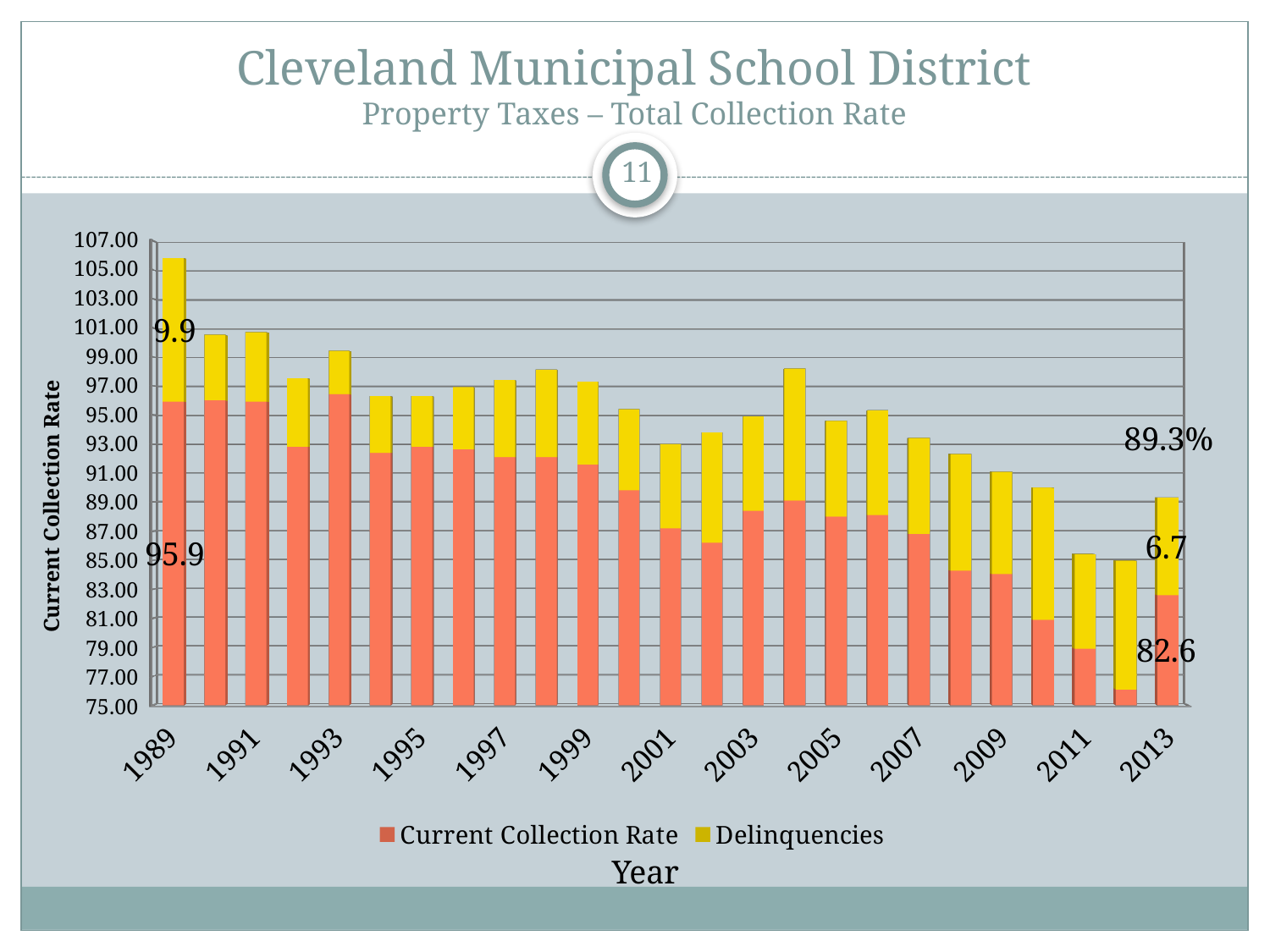
What is the Delinquencies value for 1989? 9.9 Which year has the taller stacked bar, 1989 or 2013? 1989 What is the Delinquencies value for 2013? 6.7 Is the Current Collection Rate for 2009 greater or less than 85.00? less What is the total of the stacked bar for 1989 (Current Collection Rate plus Delinquencies)? 105.8 What is the Current Collection Rate for 2013? 82.6 Does the Current Collection Rate generally rise or fall from 1989 to 2013? fall What kind of chart is shown on the slide? bar chart What is the Current Collection Rate for 1989? 95.9 What is the total collection rate labelled for 2013? 89.3% What is the difference between the Current Collection Rate in 1989 and in 2013? 13.3 How many series does the legend list? 2